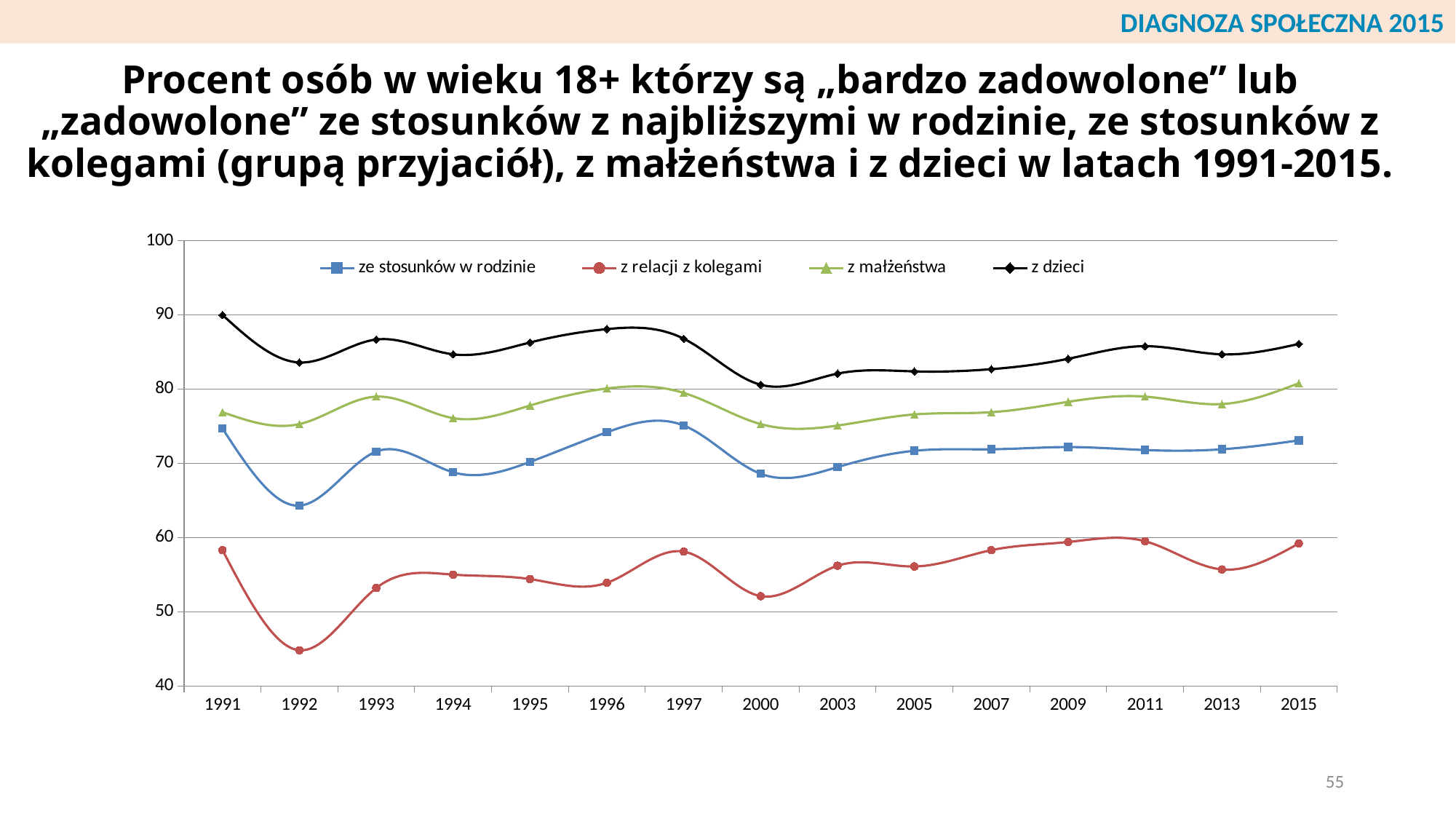
Is the value for "z relacji z kolegami" in 1992 greater or less than 50? less Which series has the highest values across all years? z dzieci In which year is the "z relacji z kolegami" series at its lowest? 1992 How many years are plotted along the x axis? 15 In which year is the "ze stosunków w rodzinie" series at its lowest? 1992 How many series does the legend list? 4 Is the value for "ze stosunków w rodzinie" in 1992 greater or less than 70? less Does the "z relacji z kolegami" series rise or fall from 1991 to 1992? fall In 2000, which is larger: the value for "z dzieci" or the value for "z relacji z kolegami"? z dzieci What kind of chart is shown on the slide? line chart Is the value for "z dzieci" in 1996 greater or less than 80? greater